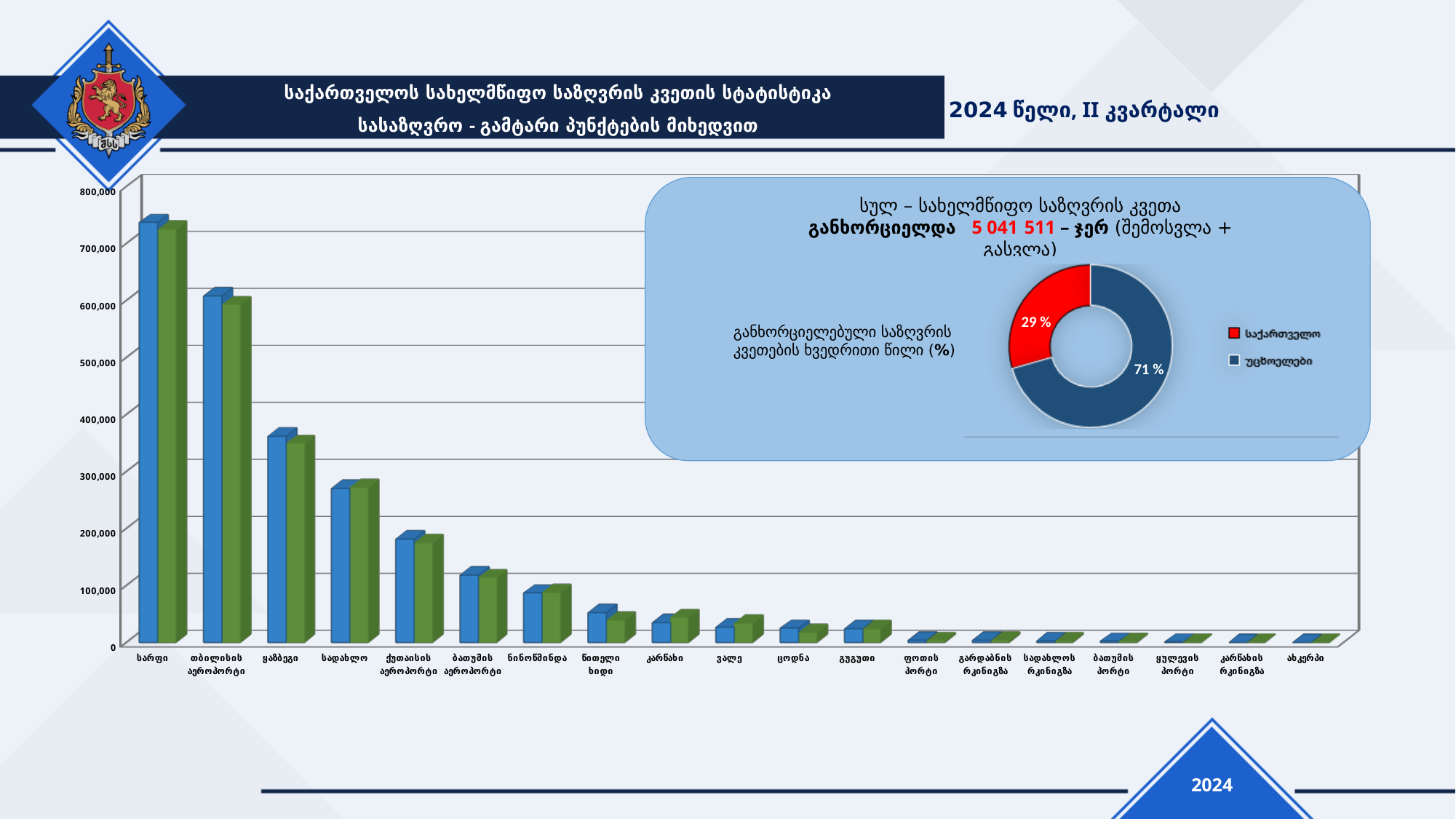
In the bar chart on the left, is the blue bar for სადახლო greater or less than 300,000? less How many categories are shown along the x axis of the bar chart on the left? 19 In the bar chart on the left, do the values rise or fall moving from left to right along the x axis? fall In the bar chart on the left, is the blue bar for ყაზბეგი greater or less than 400,000? less In the doughnut chart on the right, what is the difference between the share for უცხოელები and the share for საქართველო? 42 % In the doughnut chart on the right, what share is shown for საქართველო? 29 % In the bar chart on the left, which has larger values: თბილისის აეროპორტი or ყაზბეგი? თბილისის აეროპორტი In the bar chart on the left, which category has the highest values? სარფი How many entries does the legend of the doughnut chart on the right list? 2 In the bar chart on the left, is the blue bar for სარფი greater or less than 700,000? greater What kind of chart is the large chart on the left side of the slide? bar chart In the doughnut chart on the right, what share is shown for უცხოელები? 71 %